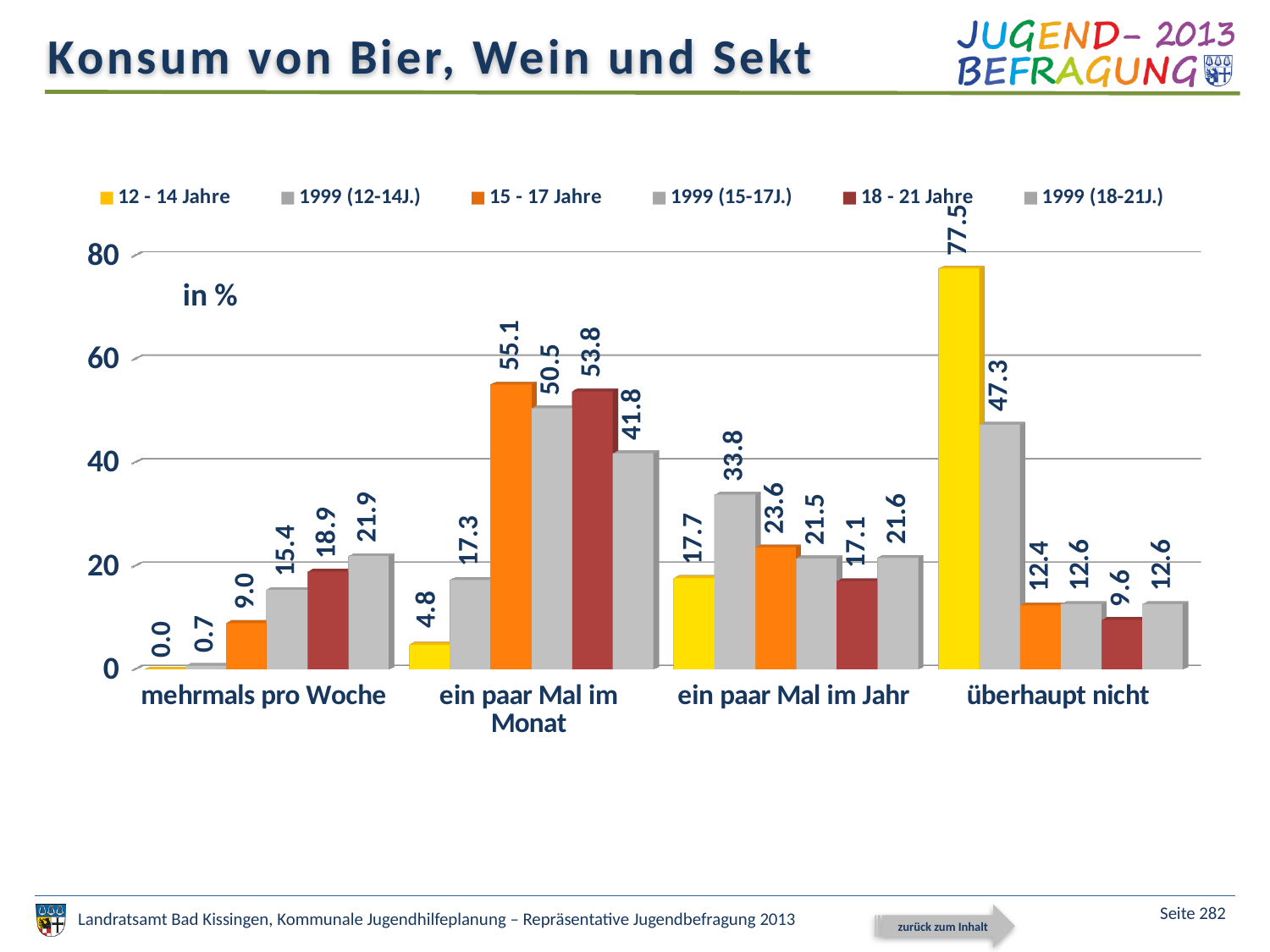
What unit is indicated for the values on the chart? in % How many categories are shown on the x axis? 4 Which category has the lowest value for the 18 - 21 Jahre series? überhaupt nicht In the category 'ein paar Mal im Monat', which is larger: the value for 15 - 17 Jahre or the value for 1999 (15-17J.)? 15 - 17 Jahre What is the value for 1999 (12-14J.) in the category 'ein paar Mal im Jahr'? 33.8 What is the value for 15 - 17 Jahre in the category 'ein paar Mal im Monat'? 55.1 What is the value for 18 - 21 Jahre in the category 'mehrmals pro Woche'? 18.9 How many series does the legend list? 6 What is the value for 12 - 14 Jahre in the category 'überhaupt nicht'? 77.5 What kind of chart is shown on the slide? bar chart What is the difference between the 12 - 14 Jahre value and the 1999 (12-14J.) value in the category 'überhaupt nicht'? 30.2 Which category has the highest value for the 12 - 14 Jahre series? überhaupt nicht